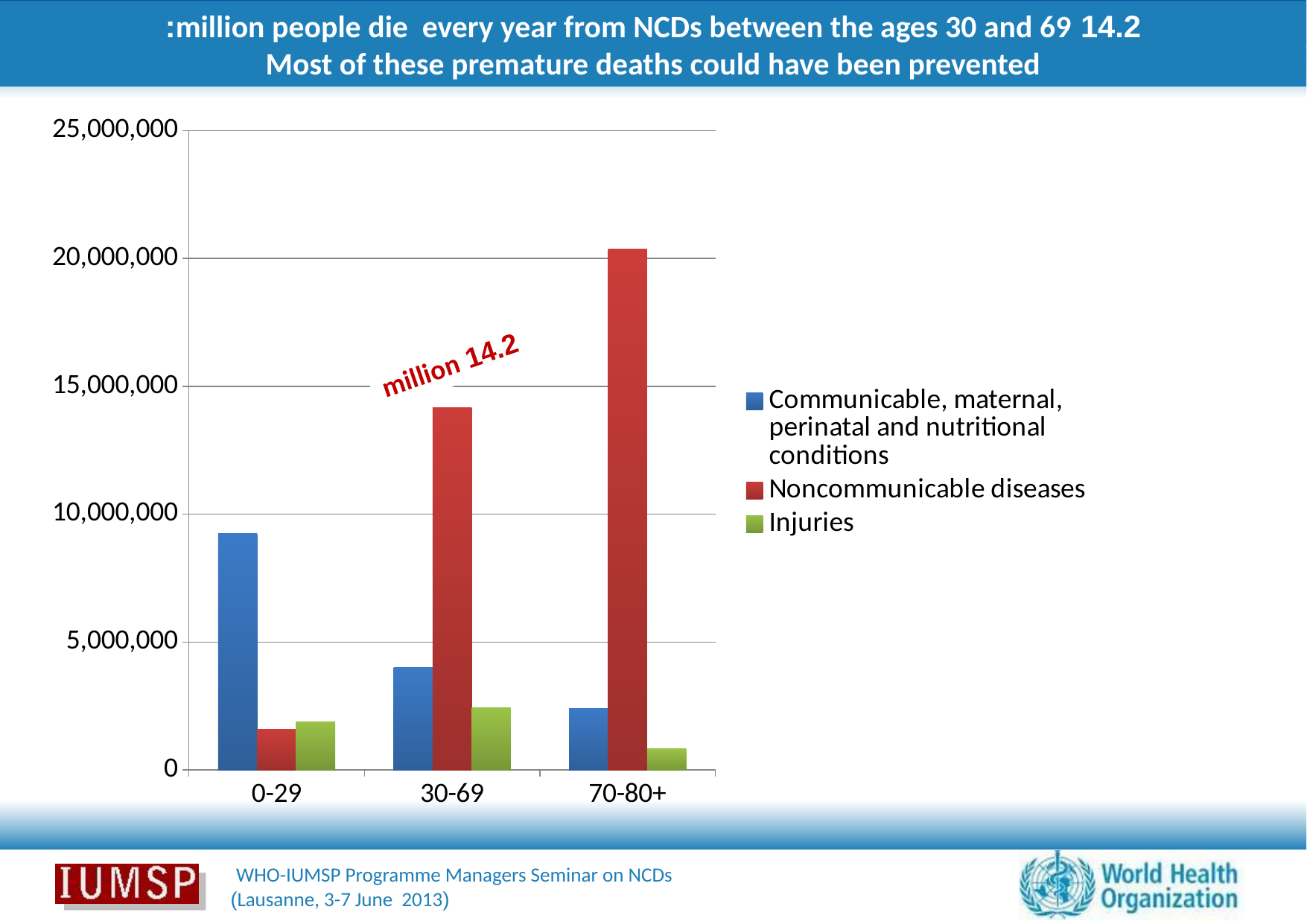
What kind of chart is shown on the slide? bar chart Which colour represents Injuries in the chart? green In which age group is the Injuries bar lowest? 70-80+ In which age group is the Communicable, maternal, perinatal and nutritional conditions bar highest? 0-29 In which age group is the Noncommunicable diseases bar highest? 70-80+ How many series does the legend list? 3 How many age-group categories are shown on the x axis? 3 Is the value for Communicable, maternal, perinatal and nutritional conditions in the 0-29 age group greater or less than 10,000,000? less Do the Noncommunicable diseases values rise or fall as the age groups increase along the x axis? rise What value is annotated on the chart for Noncommunicable diseases in the 30-69 age group? 14.2 million In the 0-29 age group, which is larger: Communicable, maternal, perinatal and nutritional conditions or Noncommunicable diseases? Communicable, maternal, perinatal and nutritional conditions Is the value for Noncommunicable diseases in the 70-80+ age group greater or less than 20,000,000? greater